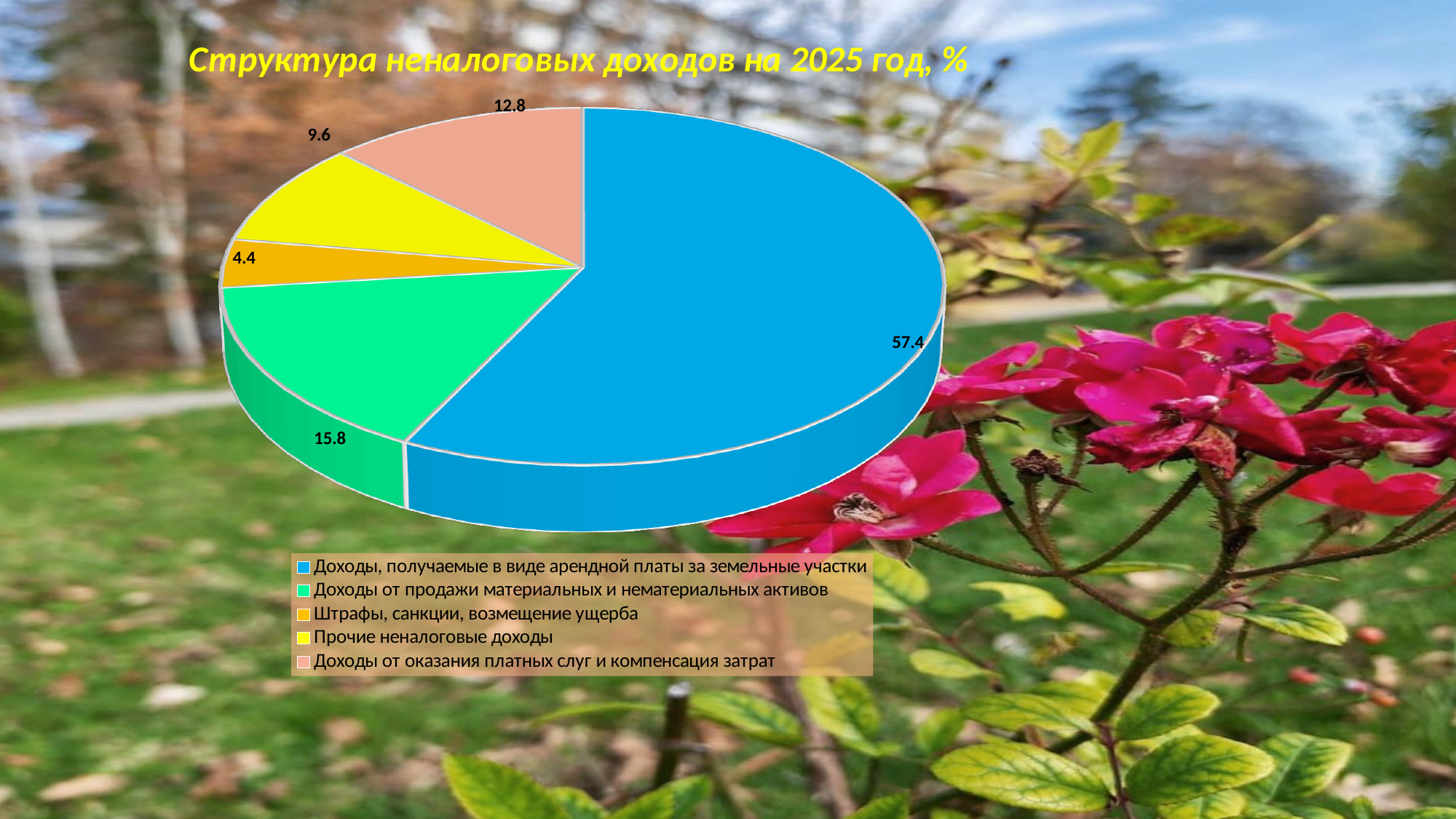
What is the value for «Доходы, получаемые в виде арендной платы за земельные участки»? 57.4 What is the value for «Доходы от продажи материальных и нематериальных активов»? 15.8 What is the value for «Доходы от оказания платных слуг и компенсация затрат»? 12.8 How many slices does the pie chart have? 5 What is the difference between the values for «Доходы от продажи материальных и нематериальных активов» and «Доходы от оказания платных слуг и компенсация затрат»? 3 What is the value for «Штрафы, санкции, возмещение ущерба»? 4.4 What kind of chart is shown on the slide? Pie chart Which category has the largest share of the pie? Доходы, получаемые в виде арендной платы за земельные участки What is the title of the chart? Структура неналоговых доходов на 2025 год, % Which is larger: «Прочие неналоговые доходы» or «Доходы от оказания платных слуг и компенсация затрат»? Доходы от оказания платных слуг и компенсация затрат Which category has the smallest share of the pie? Штрафы, санкции, возмещение ущерба What is the value for «Прочие неналоговые доходы»? 9.6